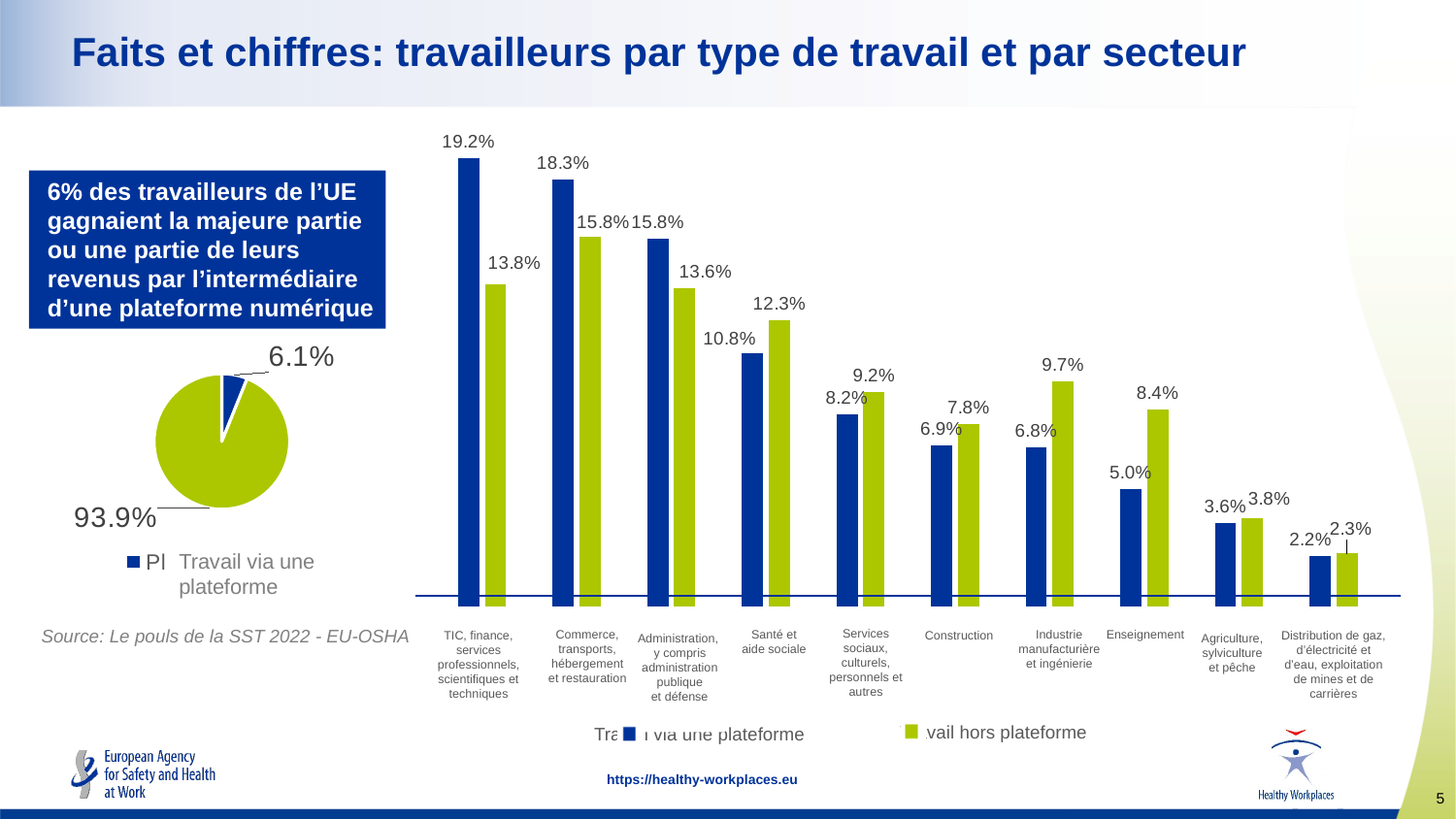
In the bar chart, what is the value for 'Travail via une plateforme' in the Construction category? 6.9% How many series does the legend of the bar chart list? 2 In the pie chart, what is the value of the larger slice? 93.9% In the bar chart, do the 'Travail via une plateforme' values generally rise or fall from left to right along the x axis? Fall In the bar chart, which category has the lowest value for 'Travail hors plateforme'? Distribution de gaz, d'électricité et d'eau, exploitation de mines et de carrières What kind of chart is the chart on the right side of the slide? Bar chart How many categories are shown on the x axis of the bar chart? 10 In the bar chart, for Santé et aide sociale, which is larger: 'Travail via une plateforme' or 'Travail hors plateforme'? Travail hors plateforme In the pie chart, what share is shown for 'Travail via une plateforme'? 6.1% In the bar chart, what is the value for 'Travail hors plateforme' in the Enseignement category? 8.4% In the bar chart, which category has the highest value for 'Travail via une plateforme'? TIC, finance, services professionnels, scientifiques et techniques In the bar chart, what is the difference between the 'Travail via une plateforme' and 'Travail hors plateforme' values for Industrie manufacturière et ingénierie? 2.9%